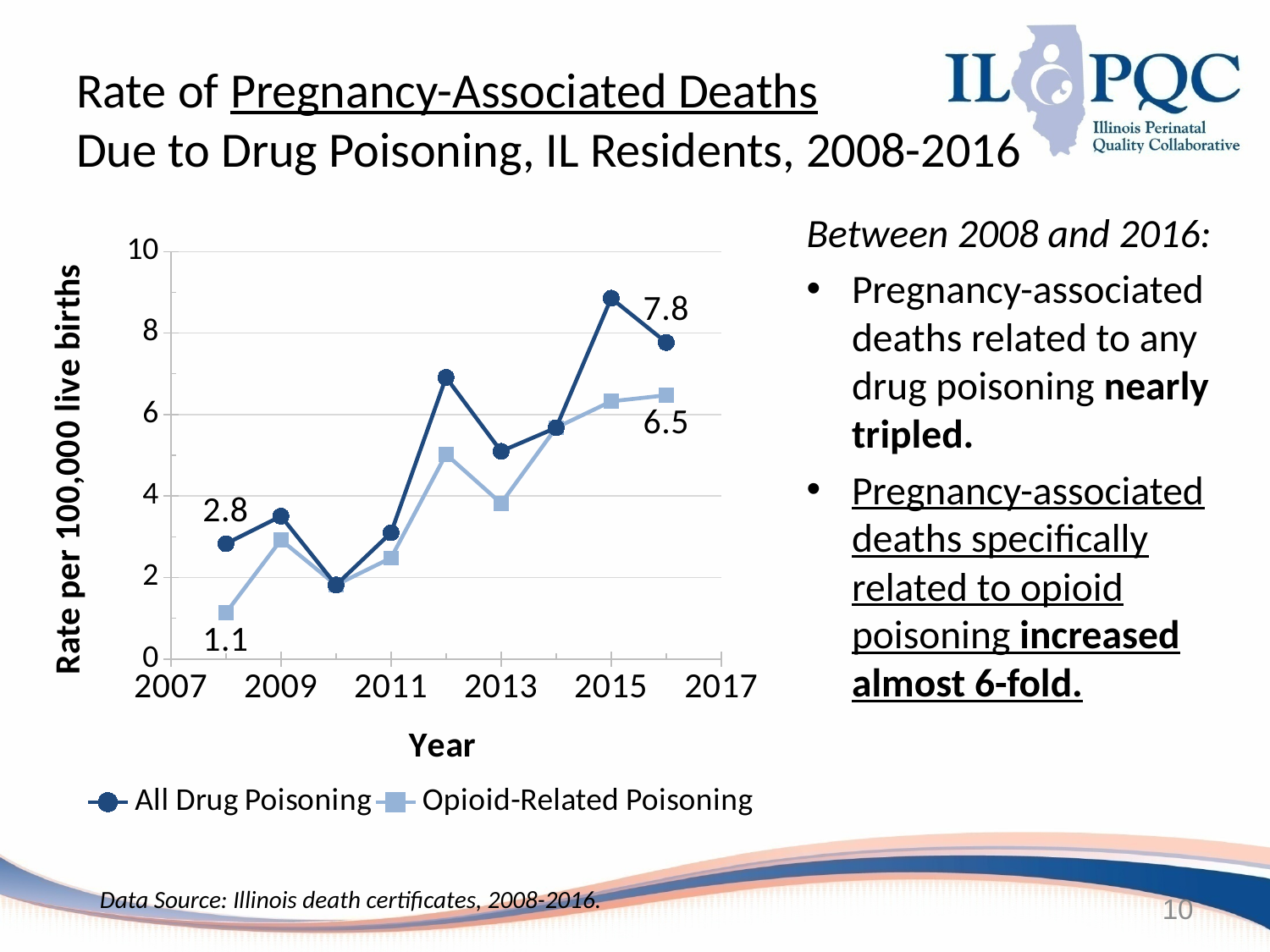
What is the Opioid-Related Poisoning rate in 2016? 6.5 What is the All Drug Poisoning rate in 2016? 7.8 What kind of chart is shown on the slide? Line chart How many series does the legend list? 2 What is the difference between the All Drug Poisoning and Opioid-Related Poisoning rates in 2016? 1.3 By how much did the All Drug Poisoning rate increase from 2008 to 2016? 5.0 What is the Opioid-Related Poisoning rate in 2008? 1.1 In 2016, which series has the higher rate, All Drug Poisoning or Opioid-Related Poisoning? All Drug Poisoning Overall, does the Opioid-Related Poisoning rate rise or fall from 2008 to 2016? Rise Is the All Drug Poisoning rate in 2015 greater or less than 8? greater In which year is the All Drug Poisoning rate highest? 2015 What is the All Drug Poisoning rate in 2008? 2.8